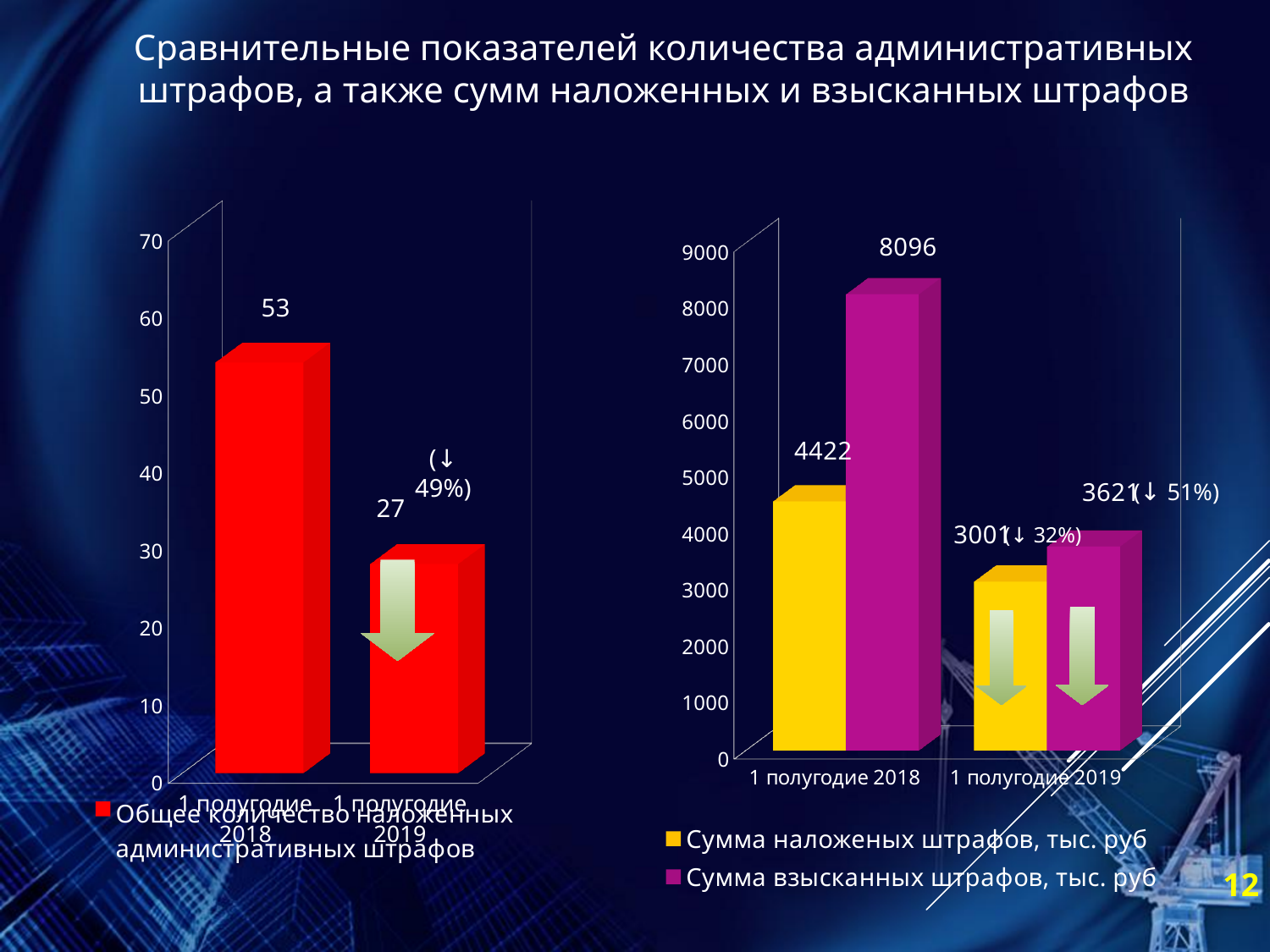
On the right chart, how many series does the legend list? 2 On the right chart, what is the value of Сумма наложеных штрафов, тыс. руб for 1 полугодие 2018? 4422 On the left chart, what is the difference between the values for 1 полугодие 2018 and 1 полугодие 2019? 26 On the left chart, what is the value for 1 полугодие 2019? 27 On the left chart, what is the value for 1 полугодие 2018? 53 On the right chart, what is the value of Сумма наложеных штрафов, тыс. руб for 1 полугодие 2019? 3001 On the right chart, what is the value of Сумма взысканных штрафов, тыс. руб for 1 полугодие 2019? 3621 On the left chart, do the values rise or fall from 1 полугодие 2018 to 1 полугодие 2019? fall On the right chart, what is the value of Сумма взысканных штрафов, тыс. руб for 1 полугодие 2018? 8096 What kind of chart is the right chart? bar chart On the left chart, which period has the higher value? 1 полугодие 2018 On the right chart, what is the difference between Сумма взысканных штрафов and Сумма наложеных штрафов for 1 полугодие 2018? 3674